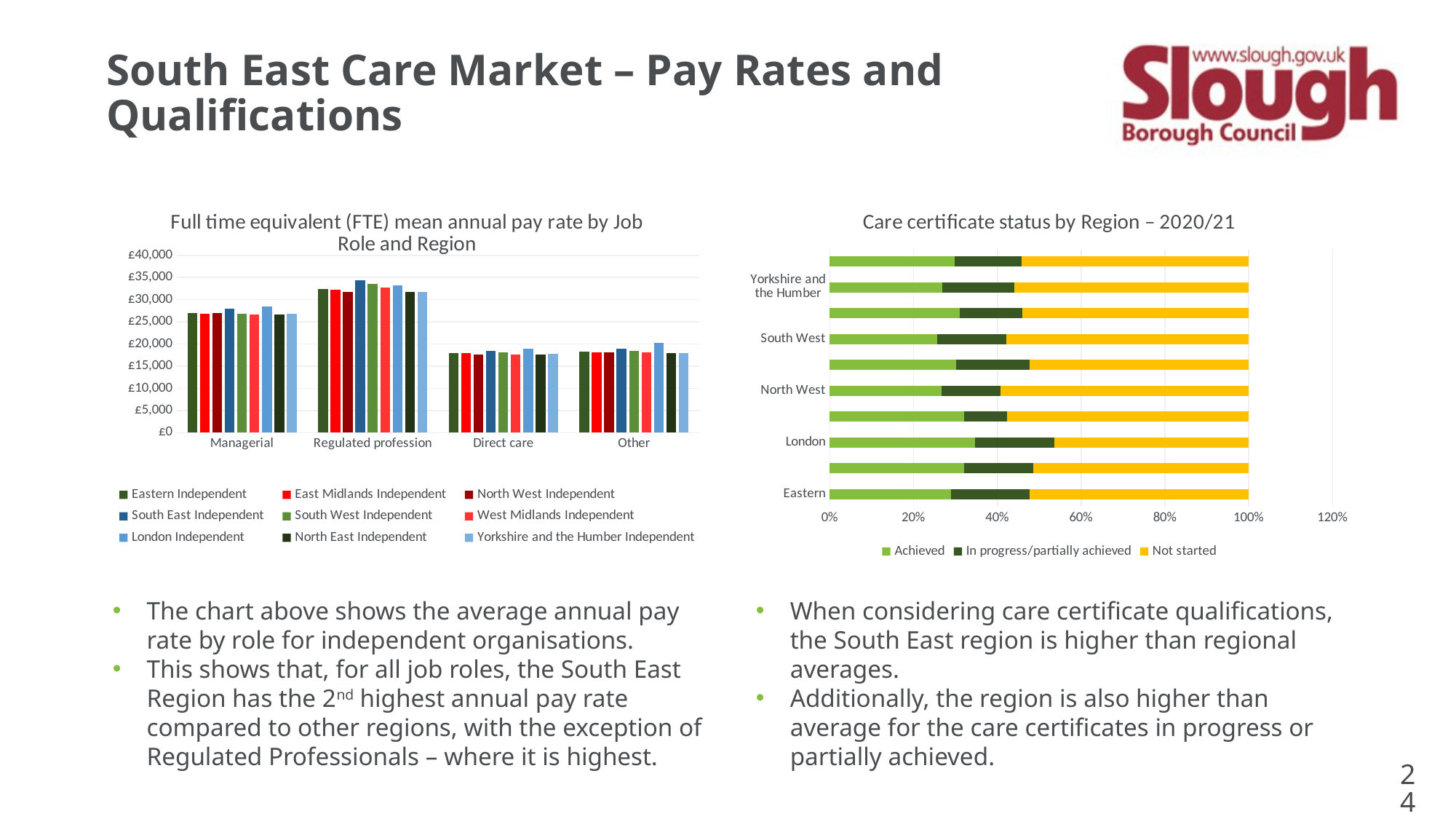
In the left chart, 'Full time equivalent (FTE) mean annual pay rate by Job Role and Region', is the South East Independent value larger for Managerial or for Regulated profession? Regulated profession How many series does the legend of the left chart, 'Full time equivalent (FTE) mean annual pay rate by Job Role and Region', list? 9 In the left chart, 'Full time equivalent (FTE) mean annual pay rate by Job Role and Region', which job role has the highest pay rates across the regions? Regulated profession How many job role categories are shown on the x axis of the left chart, 'Full time equivalent (FTE) mean annual pay rate by Job Role and Region'? 4 In the left chart, 'Full time equivalent (FTE) mean annual pay rate by Job Role and Region', is the value for South East Independent in Regulated profession greater or less than £30,000? greater In the left chart, 'Full time equivalent (FTE) mean annual pay rate by Job Role and Region', is the value for Eastern Independent in Direct care greater or less than £20,000? less In the right chart, 'Care certificate status by Region – 2020/21', is the Achieved value for London greater or less than 20%? greater How many series does the legend of the right chart, 'Care certificate status by Region – 2020/21', list? 3 What kind of chart is the left chart, 'Full time equivalent (FTE) mean annual pay rate by Job Role and Region'? Bar chart In the right chart, 'Care certificate status by Region – 2020/21', what colour represents the 'Not started' series? Yellow What kind of chart is the right chart, 'Care certificate status by Region – 2020/21'? Stacked bar chart